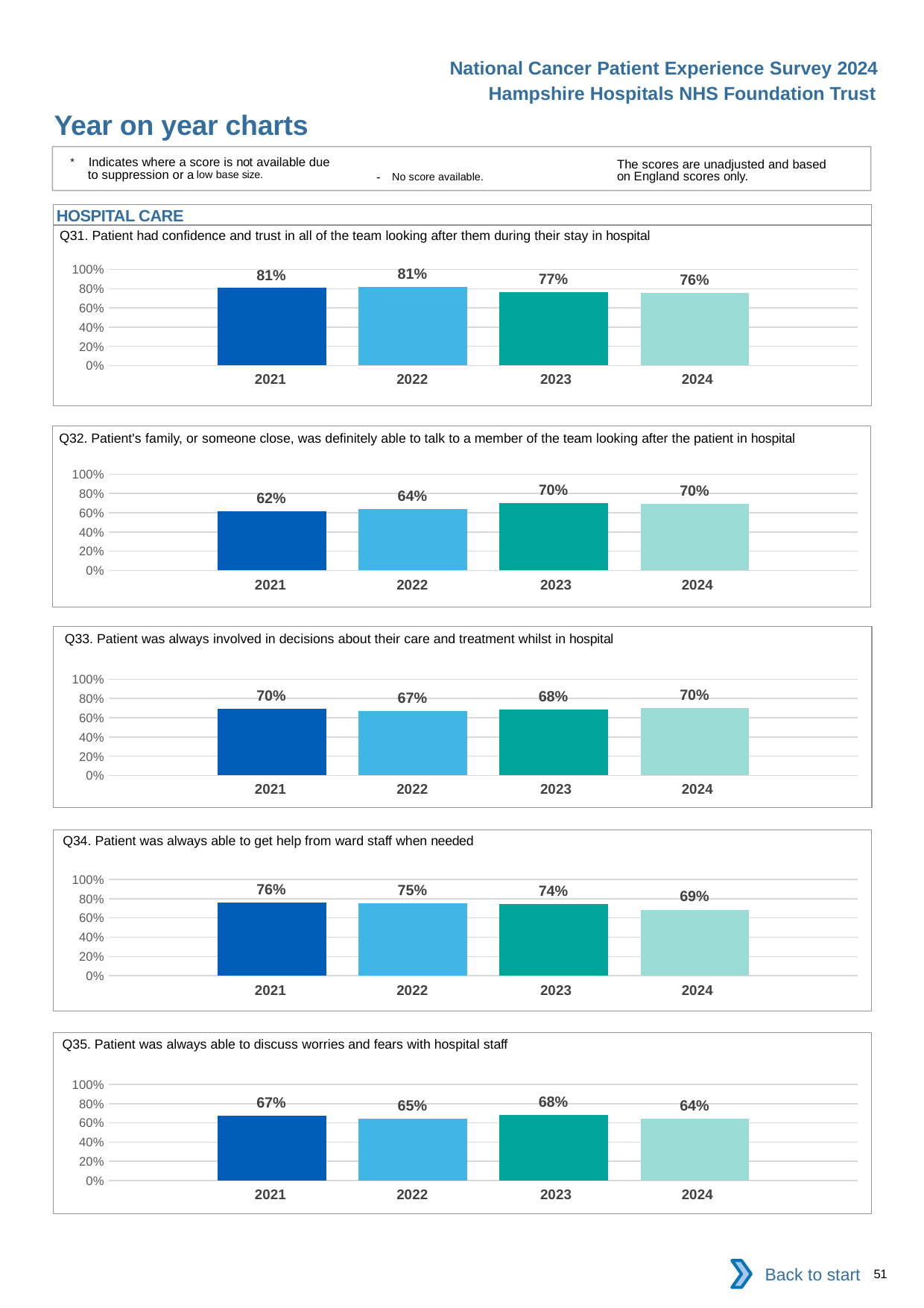
In the Q32 chart, which year has the lowest value? 2021 In the Q35 chart, what is the value for 2024? 64% In the Q34 chart, do the values rise or fall from 2021 to 2024? fall In the Q34 chart, what is the difference between the 2021 and 2024 values? 7 percentage points In the Q33 chart, what is the value for 2022? 67% In the Q31 chart, what is the value for 2023? 77% How many years are shown on the x axis of the Q31 chart? 4 What kind of chart is the Q35 chart? bar chart In the Q32 chart, is the value for 2022 larger or smaller than the value for 2023? smaller How many charts are shown on the slide? 5 In the Q35 chart, which year has the highest value? 2023 In the Q32 chart, what is the difference between the 2024 and 2021 values? 8 percentage points